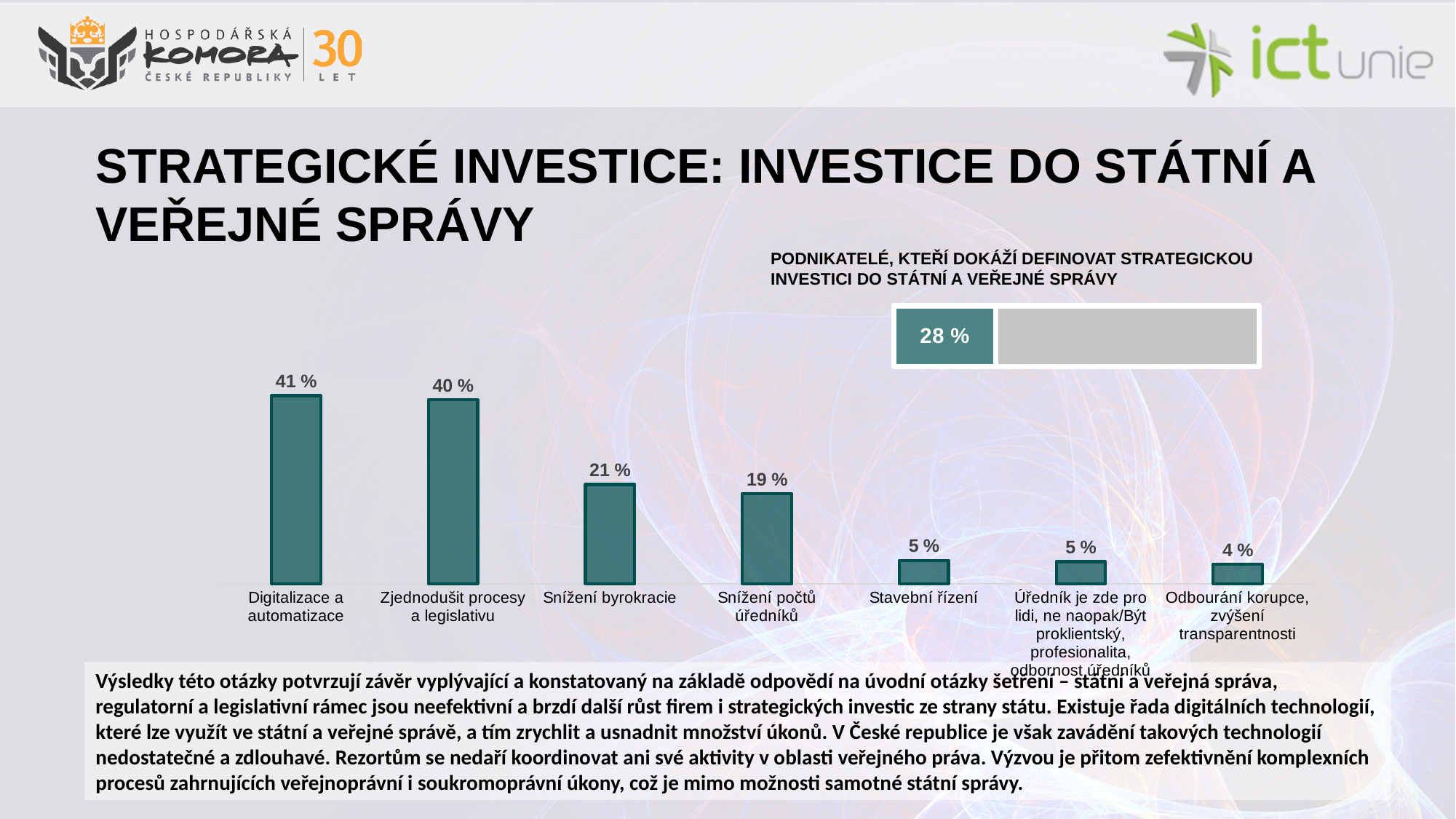
In the main bar chart, what is the difference between Zjednodušit procesy a legislativu and Snížení byrokracie? 19 % What kind of chart is the main chart on the slide? Bar chart In the main bar chart, what is the value for Snížení počtů úředníků? 19 % In the main bar chart, what is the value for Stavební řízení? 5 % In the main bar chart, which category has the highest value? Digitalizace a automatizace In the main bar chart, which is larger: Snížení byrokracie or Snížení počtů úředníků? Snížení byrokracie In the main bar chart, what is the value for Digitalizace a automatizace? 41 % In the main bar chart, which category has the lowest value? Odbourání korupce, zvýšení transparentnosti In the main bar chart, what is the value for Snížení byrokracie? 21 % How many categories does the main bar chart show? 7 Do the values in the main bar chart rise or fall from left to right? Fall In the small bar under the heading 'PODNIKATELÉ, KTEŘÍ DOKÁŽÍ DEFINOVAT STRATEGICKOU INVESTICI DO STÁTNÍ A VEŘEJNÉ SPRÁVY', what value is shown? 28 %